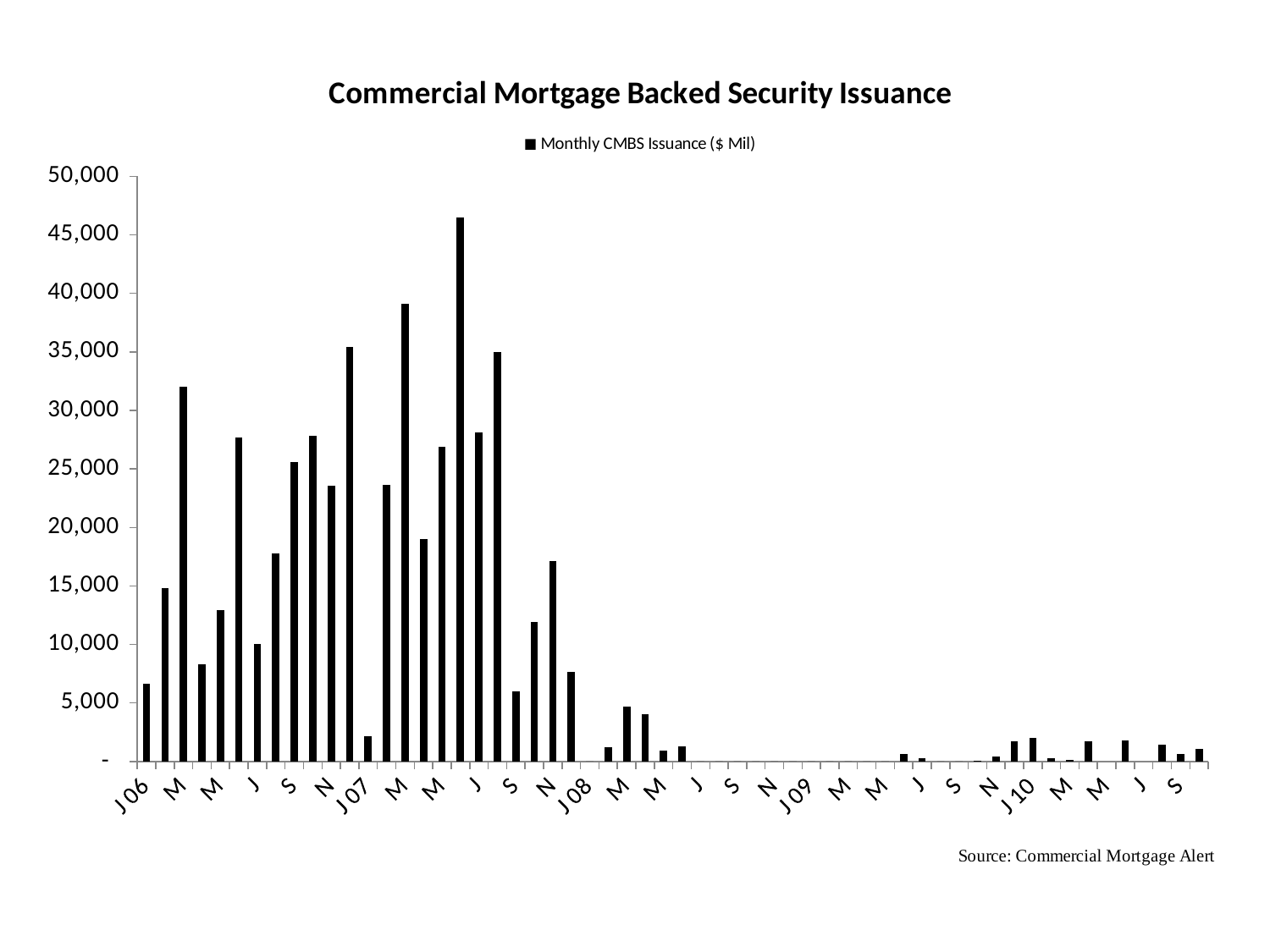
What kind of chart is shown on the slide? bar chart How many series does the legend list? 1 Is the value for the first bar labelled M (after J06) greater or less than 30,000? greater What is the title of the chart? Commercial Mortgage Backed Security Issuance Is the value for J07 greater or less than 5,000? less What series name does the legend show? Monthly CMBS Issuance ($ Mil) Is the value for J06 (the first bar) greater or less than 5,000? greater Are the bars in 2009 generally higher or lower than the bars in 2006? lower Do the values generally rise or fall from J08 to J09? fall Which is larger, the value for J06 or the value for J07? J06